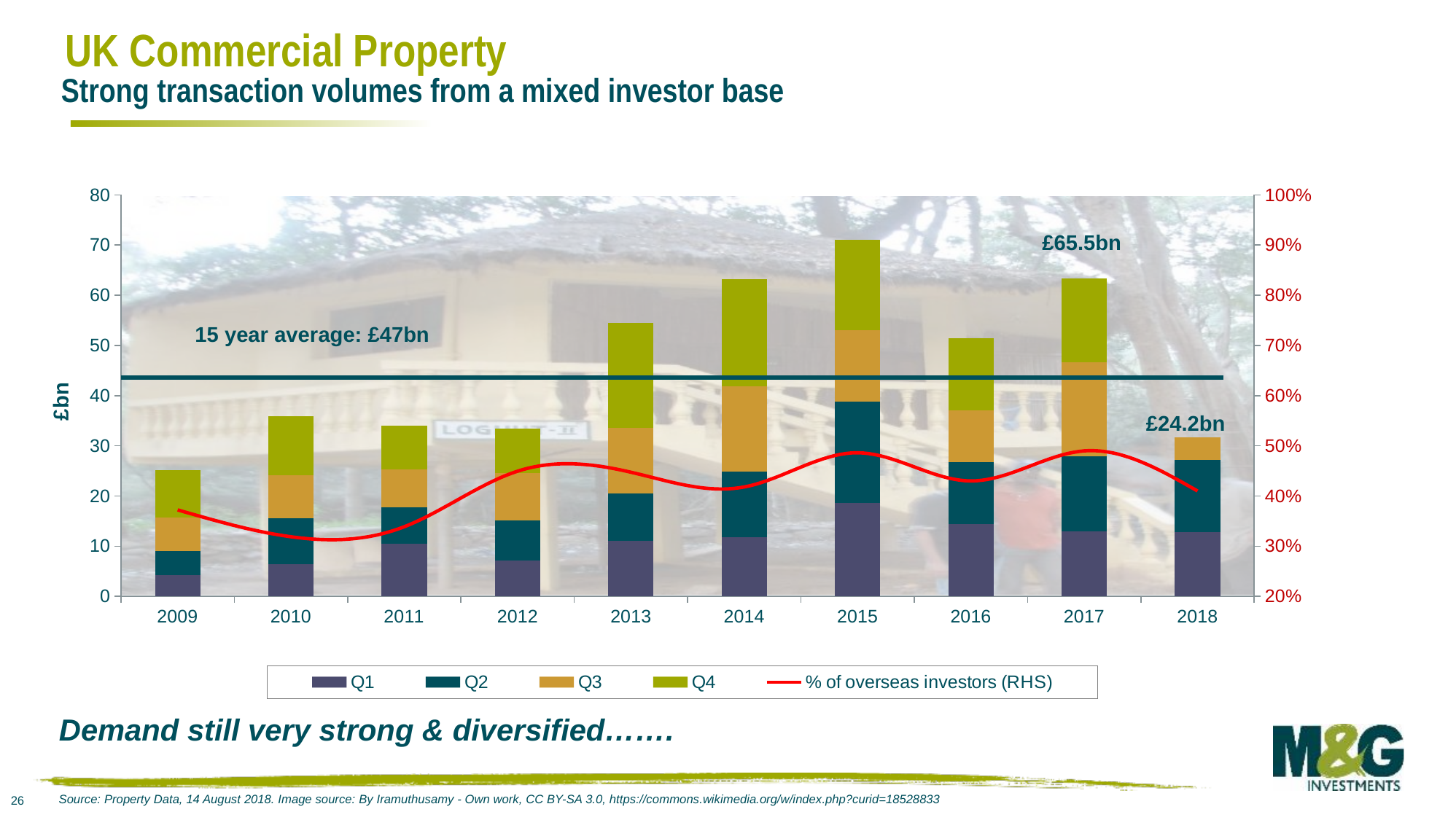
What is the 15 year average transaction volume shown on the chart? £47bn Which year has the larger total transaction volume, 2014 or 2016? 2014 How many series does the legend list? 5 Which year has the highest total transaction volume? 2015 How many years are shown on the x axis? 10 Is the total transaction volume for 2012 greater or less than 40? less What kind of chart is used to show the quarterly transaction volumes? Bar chart Is the total transaction volume for 2015 greater or less than 60? greater What value is labelled on the 2018 bar? £24.2bn What is the label on the left vertical axis? £bn Is the % of overseas investors in 2010 greater or less than 40%? less What is the labelled total transaction volume for 2017? £65.5bn